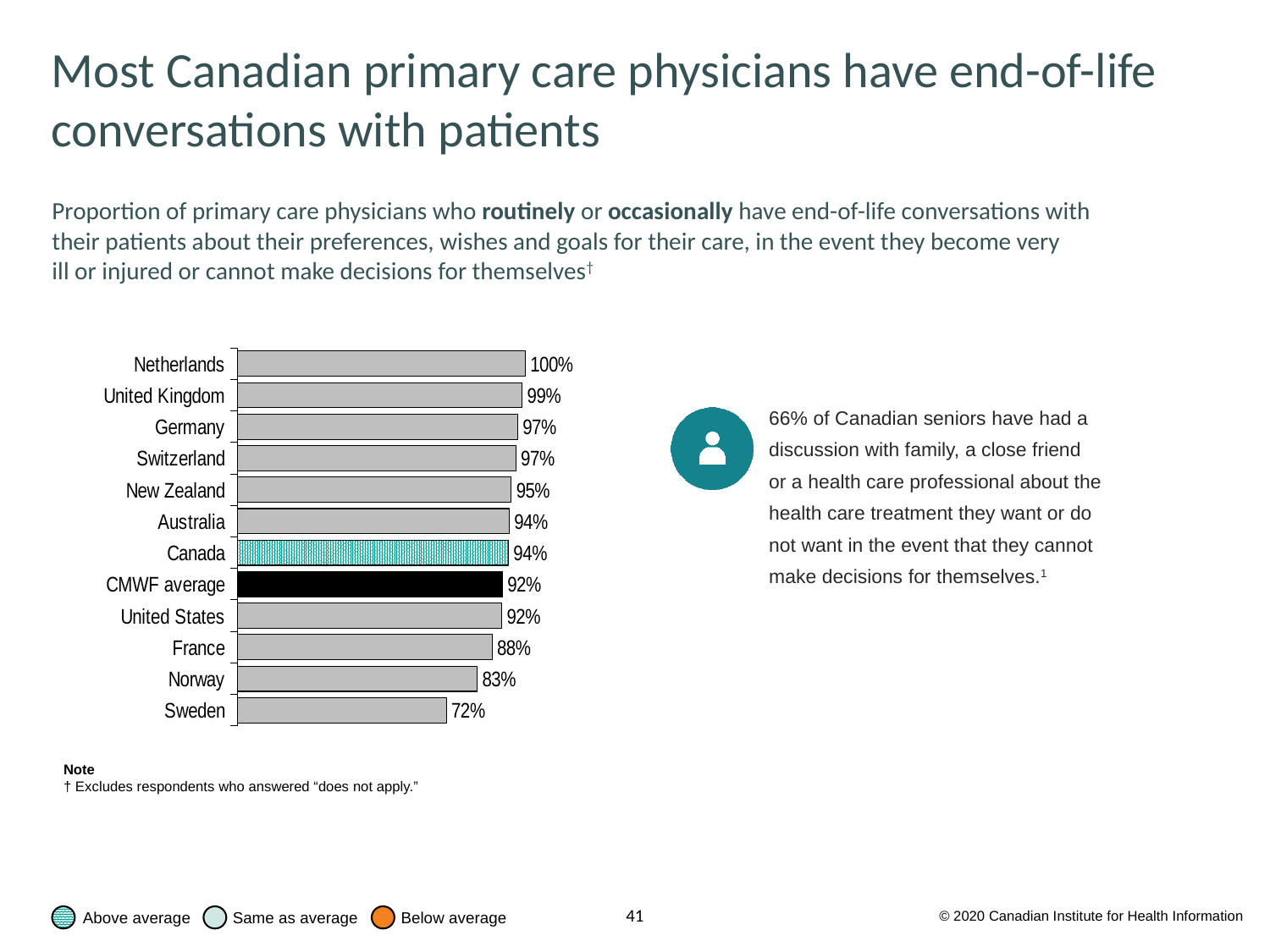
What is the value for the CMWF average? 92% Which country has the highest value? Netherlands What kind of chart is shown on the slide? Bar chart Which is larger, the value for France or the value for Norway? France What is the value for Canada? 94% Which bar is drawn in solid black? CMWF average What is the difference between the values for Canada and the CMWF average? 2% What is the value for Norway? 83% What is the value for Sweden? 72% Which country has the lowest value? Sweden What is the difference between the values for the Netherlands and Sweden? 28% How many bars are shown in the chart? 12